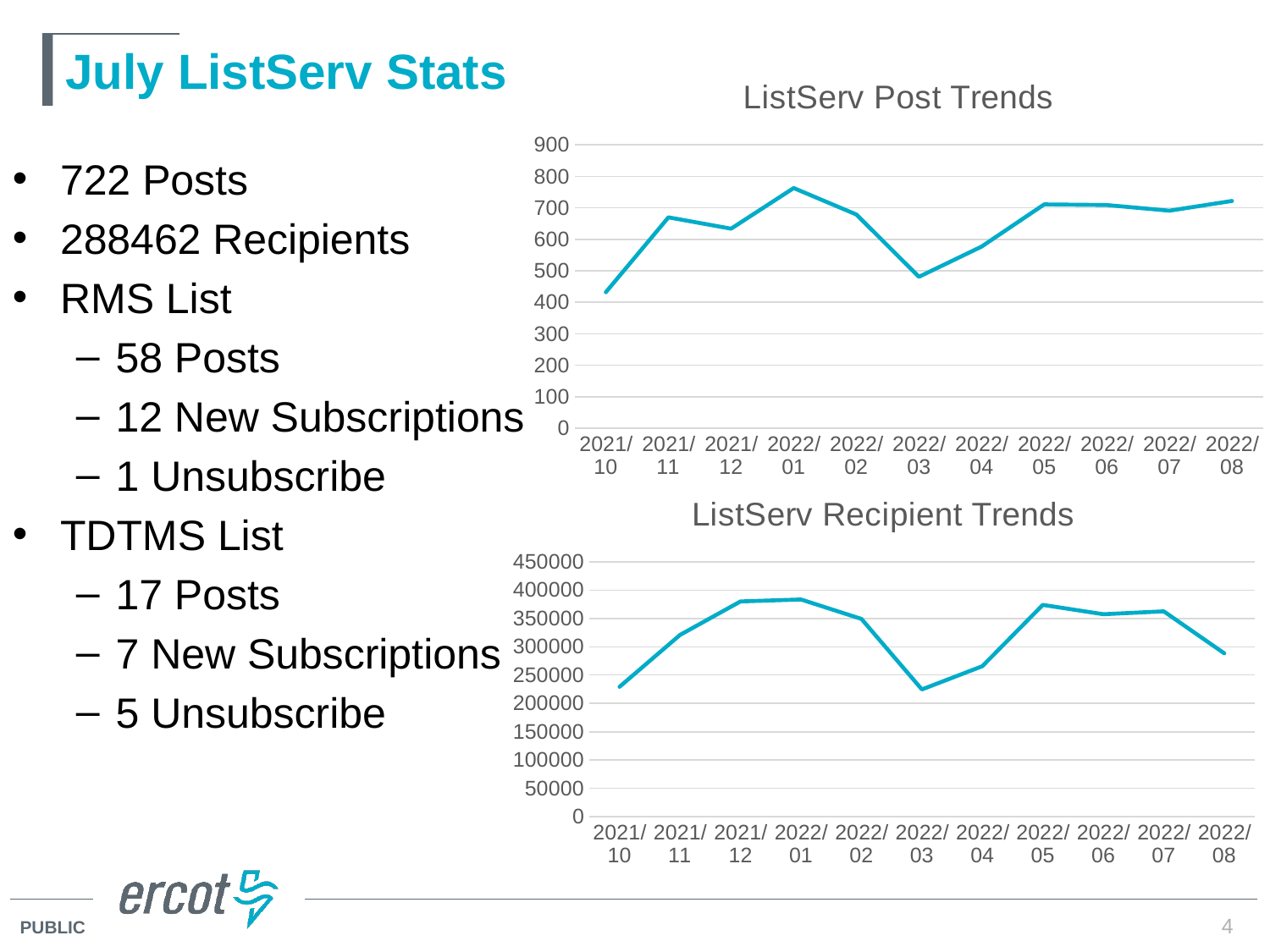
What kind of chart is the ListServ Post Trends chart? line chart In the ListServ Recipient Trends chart, is the value for 2021/12 greater or less than 350000? greater In the ListServ Post Trends chart, which is larger, the value for 2022/02 or the value for 2022/03? 2022/02 In the ListServ Recipient Trends chart, which is larger, the value for 2022/02 or the value for 2022/04? 2022/02 In the ListServ Post Trends chart, do the values rise or fall from 2022/03 to 2022/05? rise In the ListServ Recipient Trends chart, do the values rise or fall from 2021/10 to 2021/12? rise In the ListServ Post Trends chart, is the value for 2021/10 greater or less than 500? less In the ListServ Post Trends chart, is the value for 2022/01 greater or less than 700? greater In the ListServ Post Trends chart, which month has the highest value? 2022/01 In the ListServ Post Trends chart, which month has the lowest value? 2021/10 How many data points are plotted on the ListServ Recipient Trends chart? 11